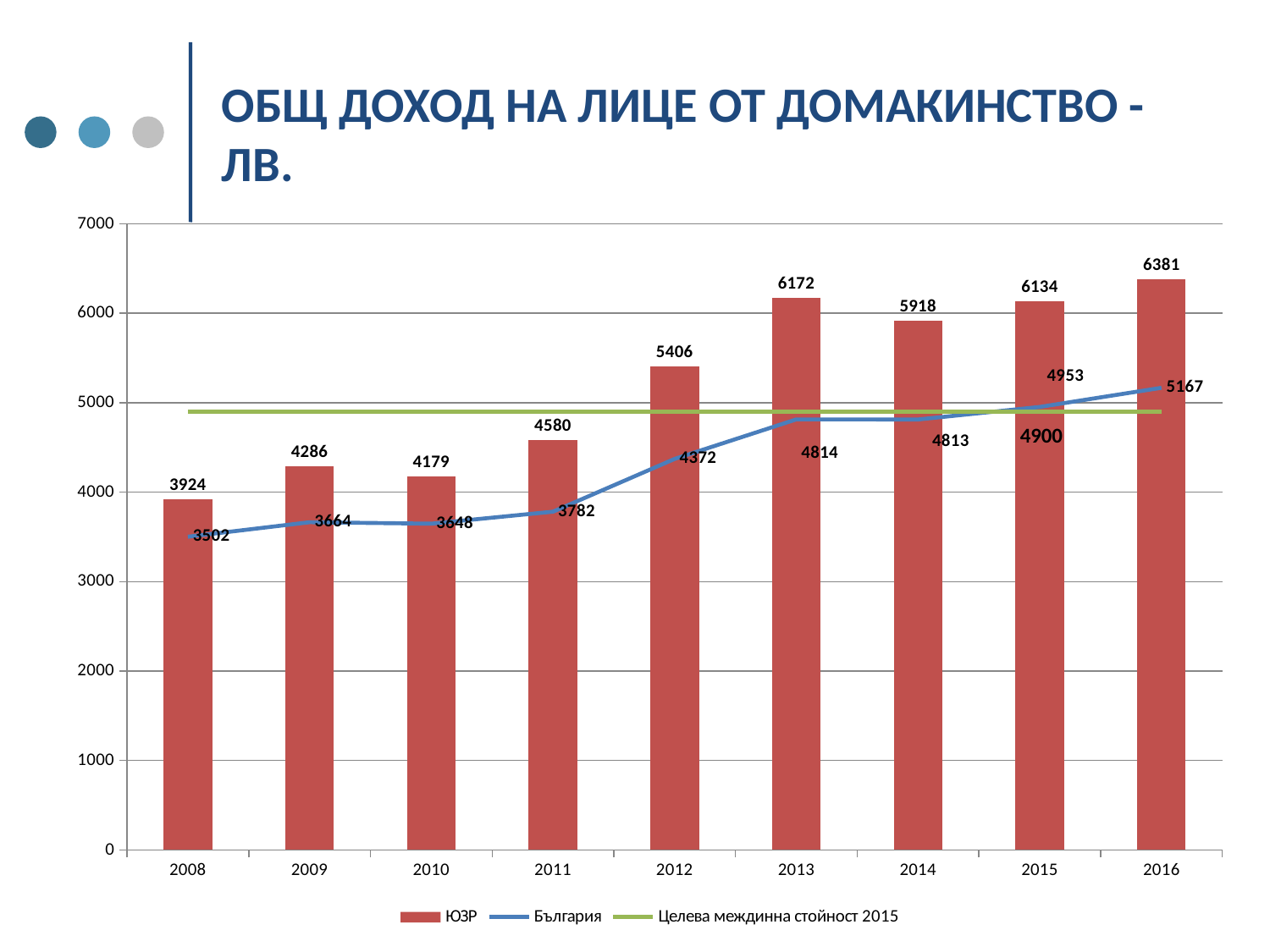
How many series does the legend list? 3 Does the България line rise or fall from 2008 to 2016 overall? rise Which year has the lowest ЮЗР bar? 2008 How many years are shown on the x axis? 9 Which year has the highest ЮЗР bar? 2016 What is the value of the България line for 2012? 4372 What kind of chart is used for the ЮЗР series? bar chart Which is larger: the България value for 2009 or the България value for 2010? 2009 What is the value of the ЮЗР bar for 2016? 6381 What is the difference between the ЮЗР value for 2013 and the ЮЗР value for 2014? 254 What is the value of the Целева междинна стойност 2015 line? 4900 Is the ЮЗР value for 2012 greater or less than 5000? greater